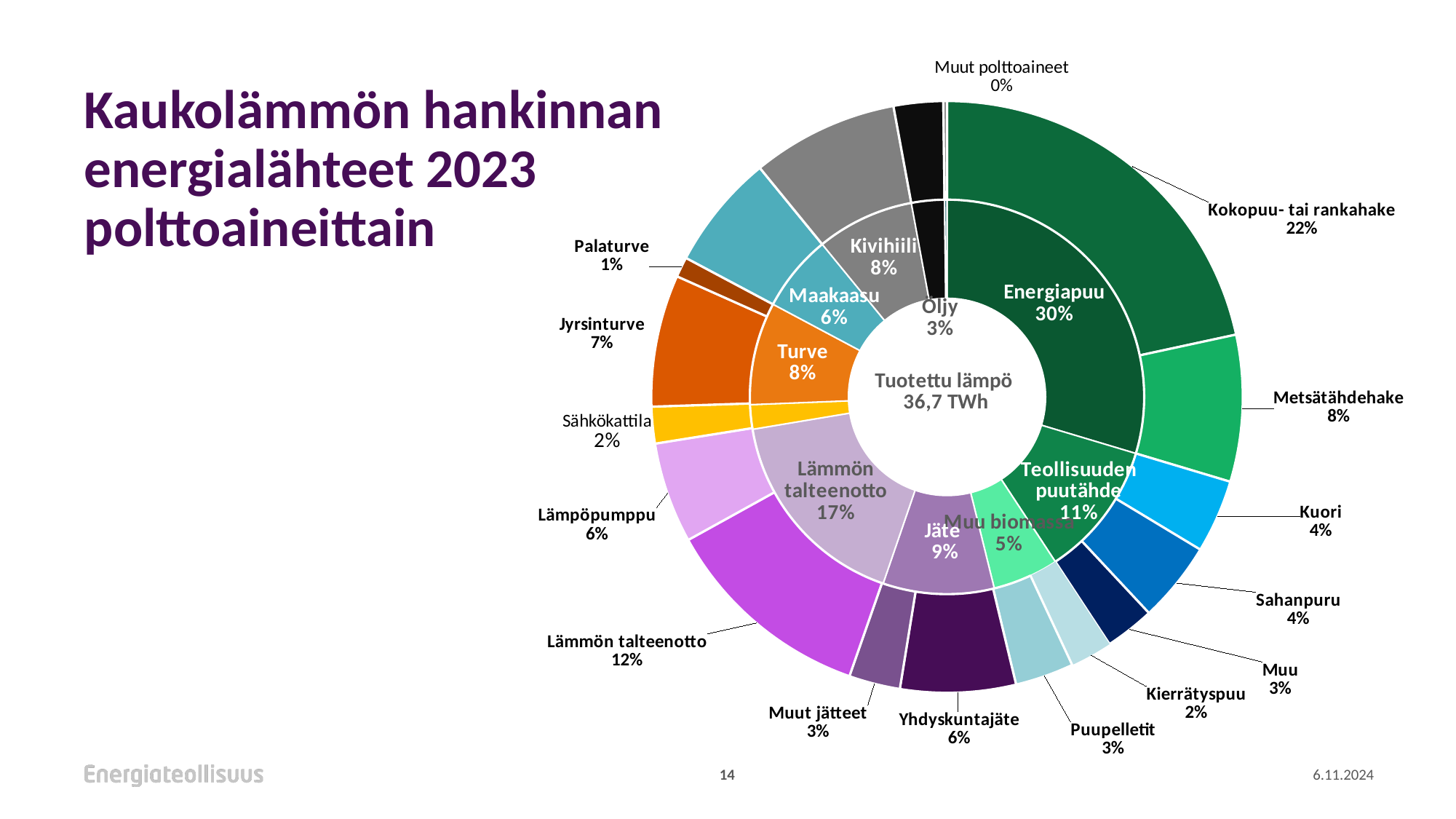
What type of chart is shown on the slide? Doughnut chart Which labelled category in the outer ring has the smallest share? Muut polttoaineet What percentage is shown for Jyrsinturve? 7% What share does Energiapuu have in the inner ring of the doughnut chart? 30% What is the difference in percentage points between Energiapuu and Lämmön talteenotto in the inner ring? 13 What percentage is shown for Kokopuu- tai rankahake in the outer ring? 22% What share is shown for Lämmön talteenotto in the inner ring? 17% What total heat production is shown in the centre of the chart? 36,7 TWh Which category in the inner ring has the largest share? Energiapuu Which has a larger share, Turve or Maakaasu? Turve How many categories are labelled in the inner ring of the chart? 9 Which has a larger share, Yhdyskuntajäte or Muut jätteet? Yhdyskuntajäte